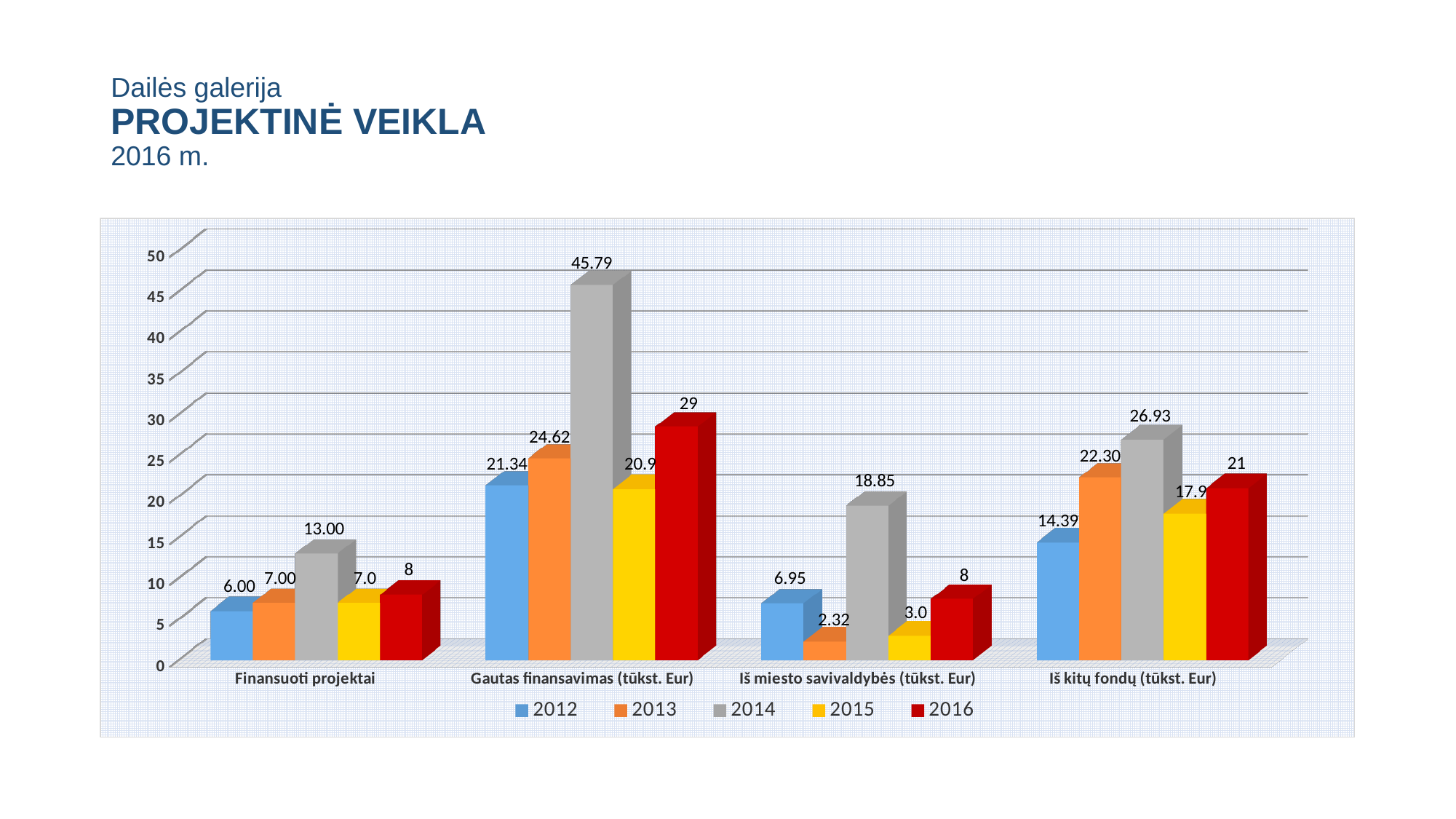
Which year has the highest value in the category "Finansuoti projektai"? 2014 What is the value for 2014 in the category "Gautas finansavimas (tūkst. Eur)"? 45.79 Is the value for 2014 in the category "Iš miesto savivaldybės (tūkst. Eur)" greater or less than 15? greater Which colour represents the 2016 series in the legend? red What is the value for 2013 in the category "Iš miesto savivaldybės (tūkst. Eur)"? 2.32 What is the difference between the 2014 and 2016 values in the category "Gautas finansavimas (tūkst. Eur)"? 16.79 What is the value for 2016 in the category "Iš kitų fondų (tūkst. Eur)"? 21 What kind of chart is shown on the slide? bar chart Which year has the lowest value in the category "Iš kitų fondų (tūkst. Eur)"? 2012 How many categories are shown on the x axis? 4 Which is larger in the category "Iš kitų fondų (tūkst. Eur)": the value for 2013 or the value for 2015? 2013 How many series does the legend list? 5